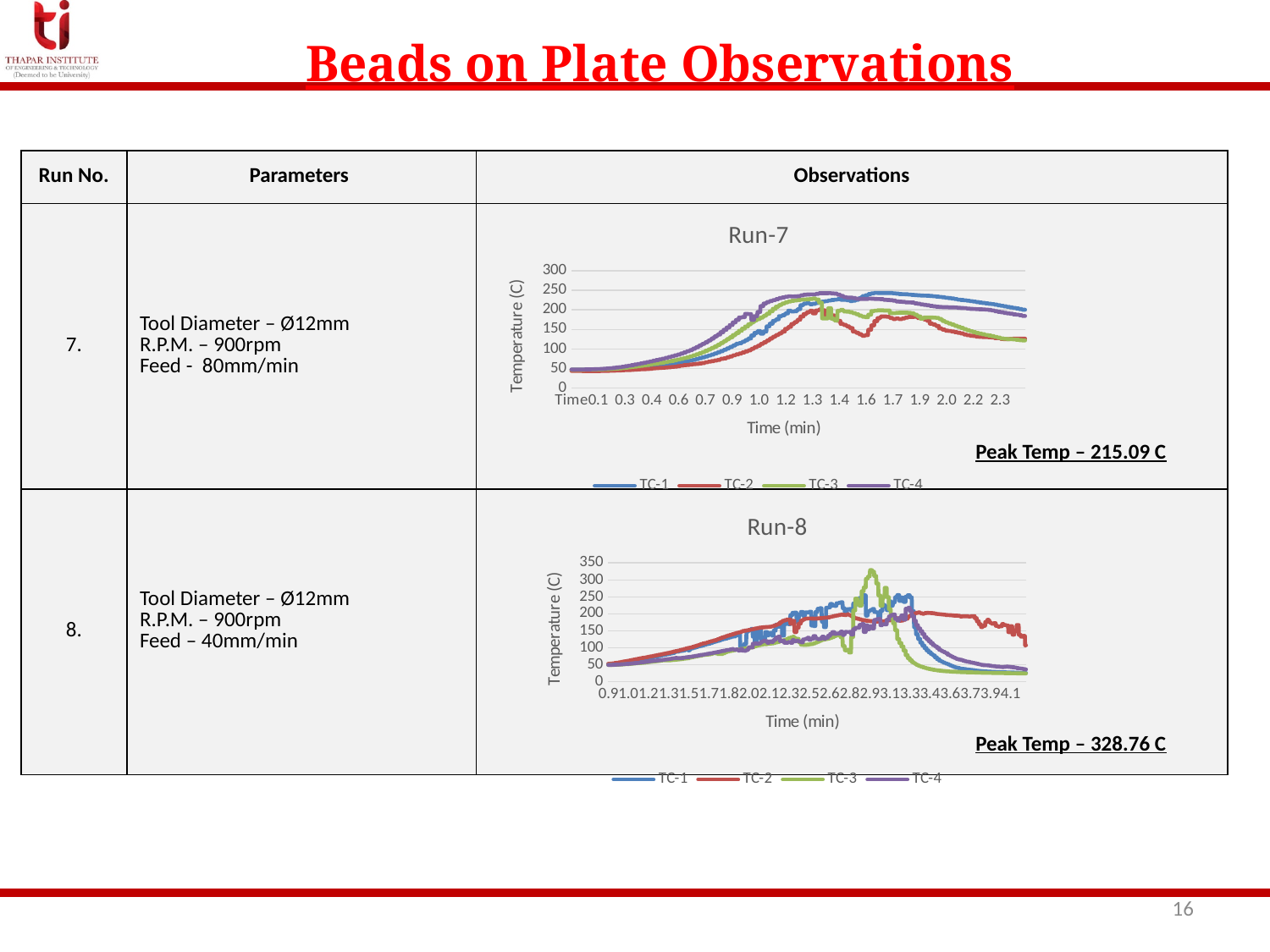
In the Run-8 chart, is the highest value reached by TC-3 greater or less than 300? greater What kind of chart is the Run-8 chart? line chart In the Run-7 chart, is the value of TC-1 at time 2.3 greater or less than 150? greater How many series does the legend of the Run-7 chart list? 4 How many series does the legend of the Run-8 chart list? 4 What is the x-axis label of the Run-7 chart? Time (min) In the Run-7 chart, is the highest value reached by any series greater or less than 300? less In the Run-7 chart, does TC-1 rise or fall between time 0.1 and time 1.3? rise In the Run-8 chart, at time 4.1, which series has the larger value, TC-2 or TC-3? TC-2 What is the y-axis label of the Run-8 chart? Temperature (C) What kind of chart is the Run-7 chart? line chart